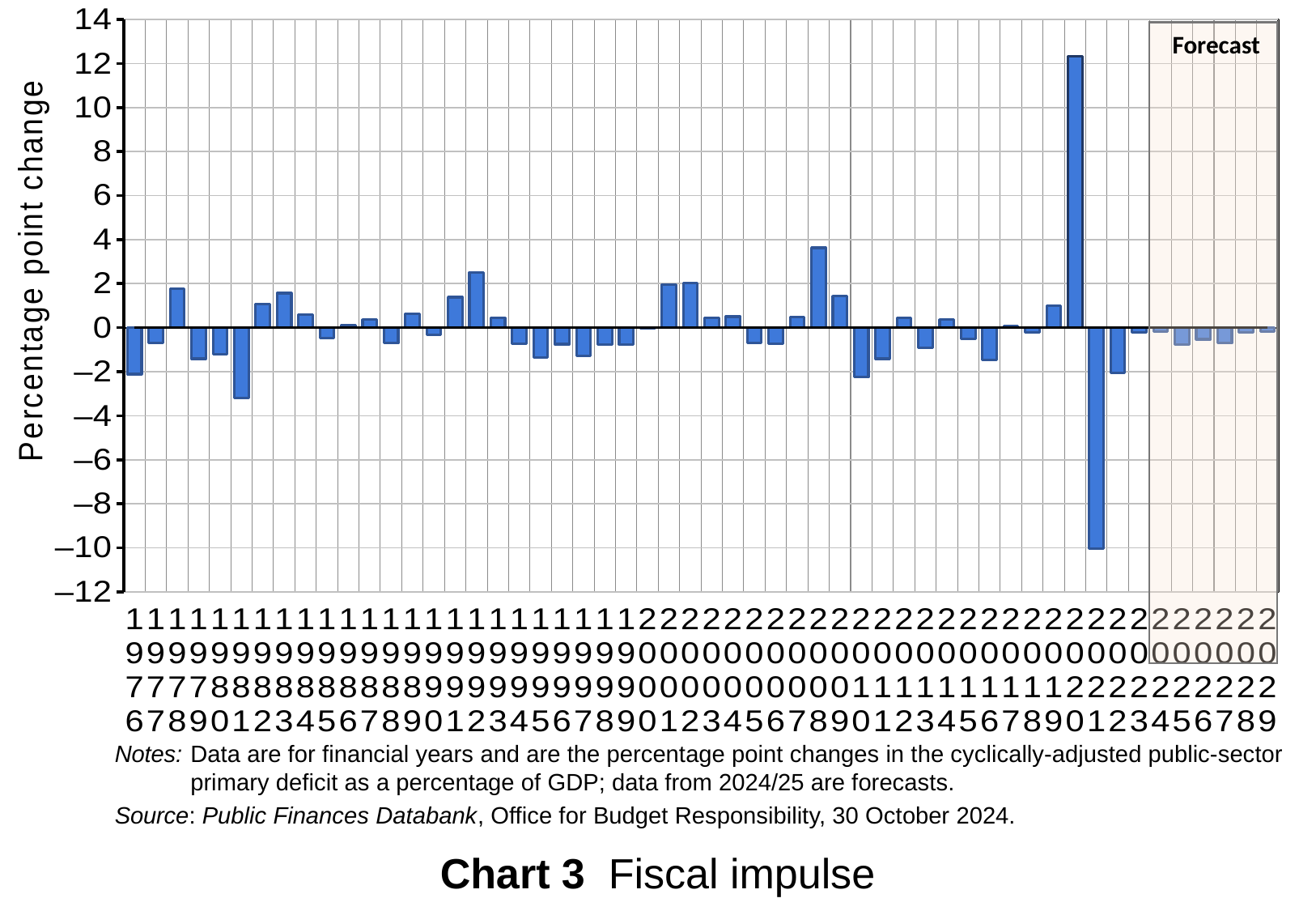
Which has the larger value, 2009 or 2020? 2020 Is the value for 1992 greater or less than 2? greater Is the value for 2009 greater or less than 2? less How many years are plotted in Chart 3? 54 Which year has the lowest value in Chart 3? 2021 Is the value for 1981 greater or less than -2? less Which has the lower value, 1981 or 2021? 2021 Which year has the highest value in Chart 3? 2020 What kind of chart is Chart 3? bar chart What is the label on the vertical axis of Chart 3? Percentage point change